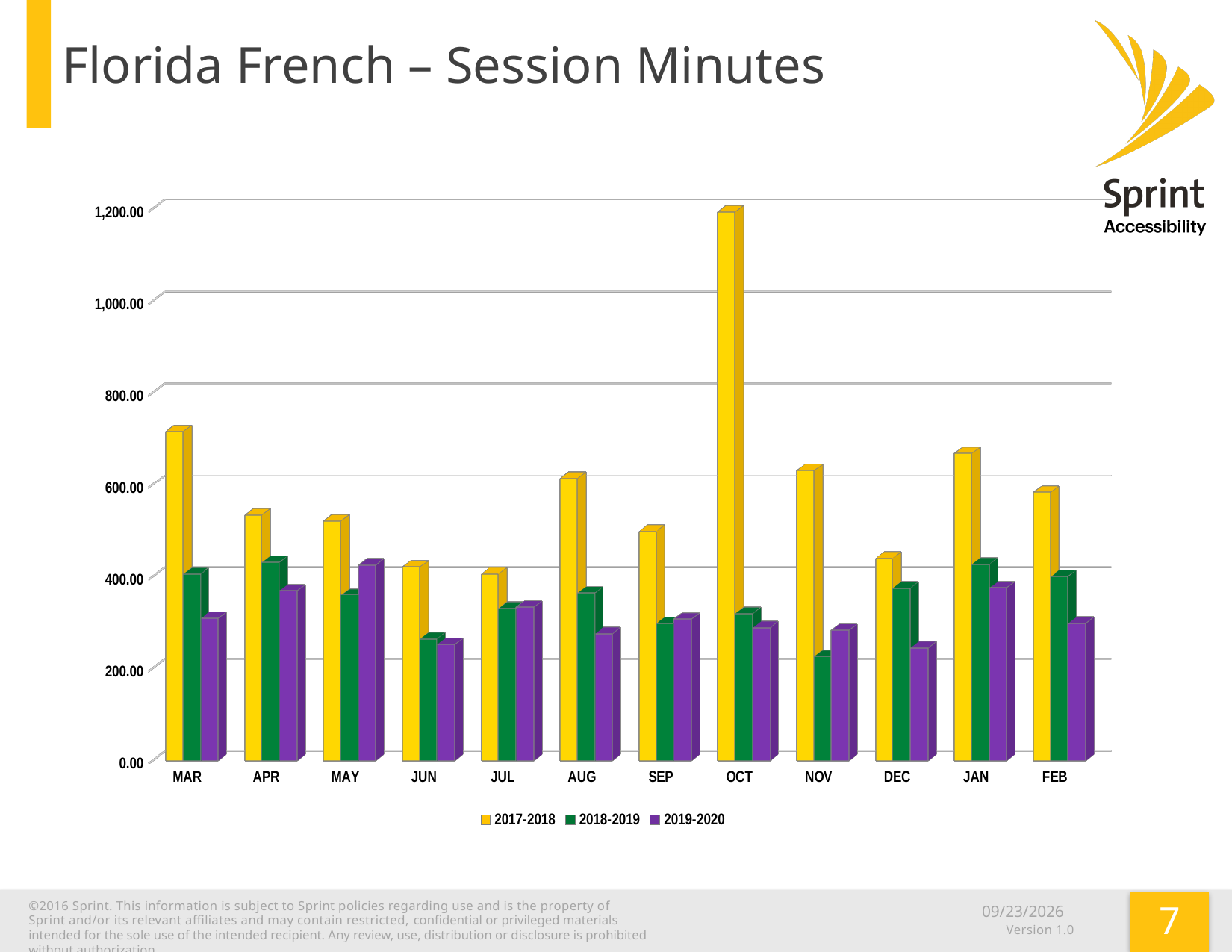
In APR, which series has the larger value, 2018-2019 or 2019-2020? 2018-2019 How many series does the legend list? 3 In which month is the 2019-2020 value highest? MAY In MAY, which series has the larger value, 2018-2019 or 2019-2020? 2019-2020 What kind of chart is shown on the slide? bar chart Which series is shown in yellow? 2017-2018 How many months are shown on the x axis? 12 Is the 2017-2018 value for OCT greater or less than 1,000.00? greater In which month is the 2018-2019 value lowest? NOV In which month is the 2017-2018 value highest? OCT Is the 2017-2018 value for MAR greater or less than 600.00? greater Is the 2018-2019 value for NOV greater or less than 400.00? less